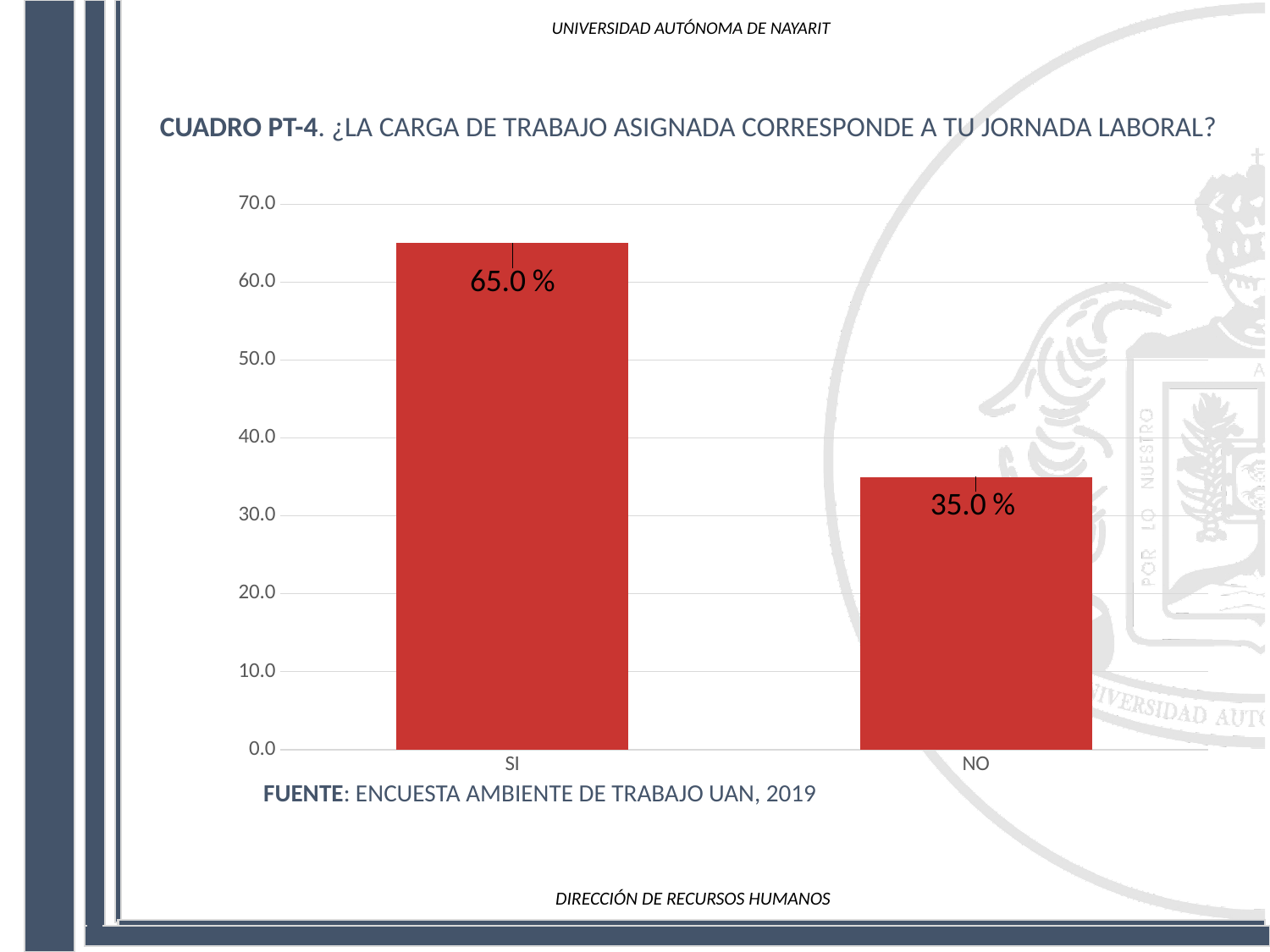
Which category has the lowest value? NO How many categories are shown on the x axis? 2 Which category has the highest value? SI Is the value for NO greater or less than 40.0? less What kind of chart is shown on the slide? bar chart What is the value for SI? 65.0 % Is the value for SI greater or less than 60.0? greater Which is larger, the value for SI or the value for NO? SI What is the difference between the values for SI and NO? 30.0 % What is the source cited below the chart? ENCUESTA AMBIENTE DE TRABAJO UAN, 2019 What is the value for NO? 35.0 % What colour are the bars in the chart? red